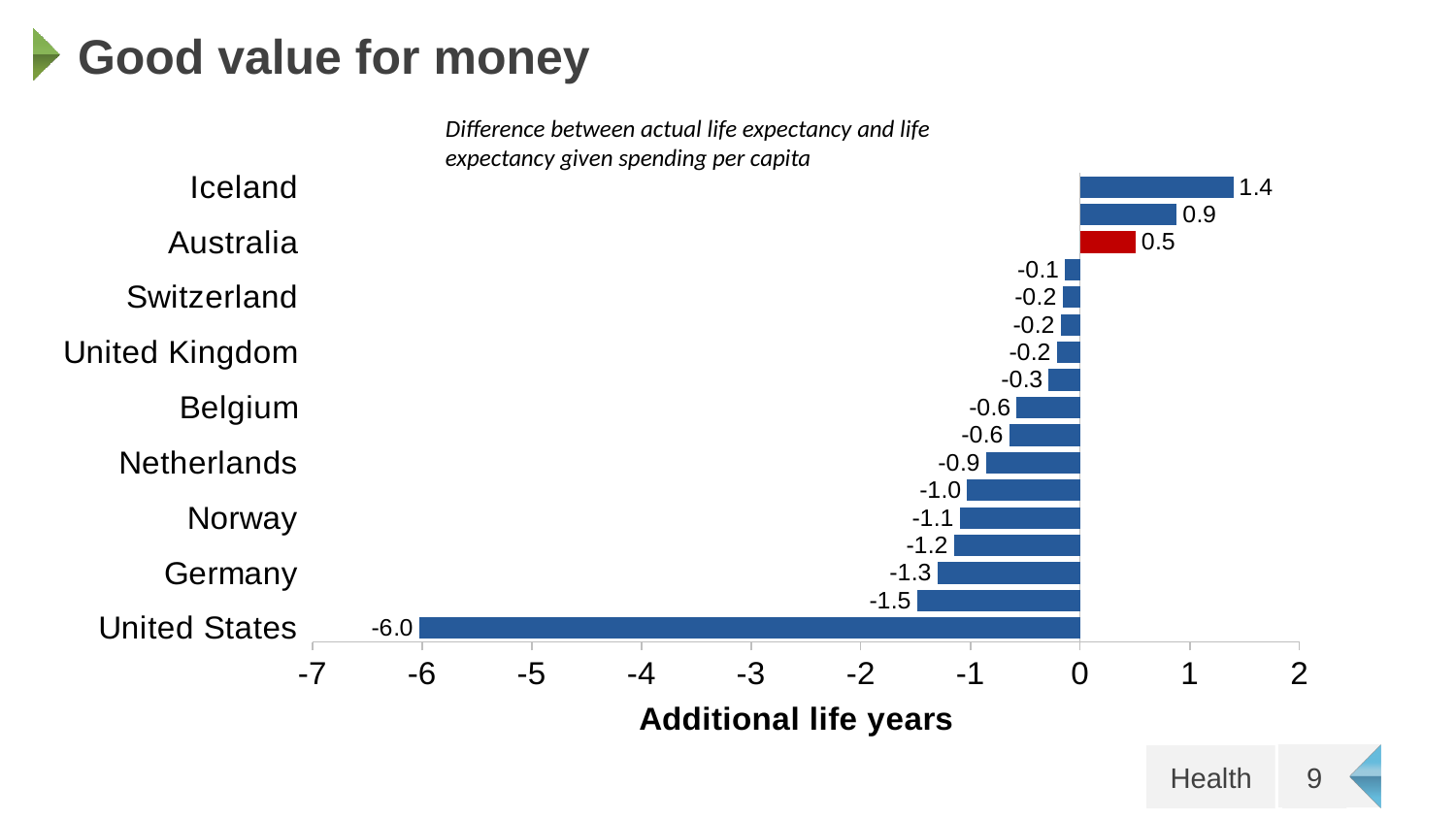
What kind of chart is shown? Bar chart Which has the larger value, Norway or Germany? Norway What is the value for the United States? -6.0 Which labelled country has the lowest value? United States Which labelled country has the highest value? Iceland How many bars are plotted in the chart? 17 What is the value for the Netherlands? -0.9 What is the difference between the values for Iceland and Australia? 0.9 What is the value for Australia? 0.5 What is the value for Iceland? 1.4 What is the value for Germany? -1.3 Is the value for the United States greater or less than -5? less